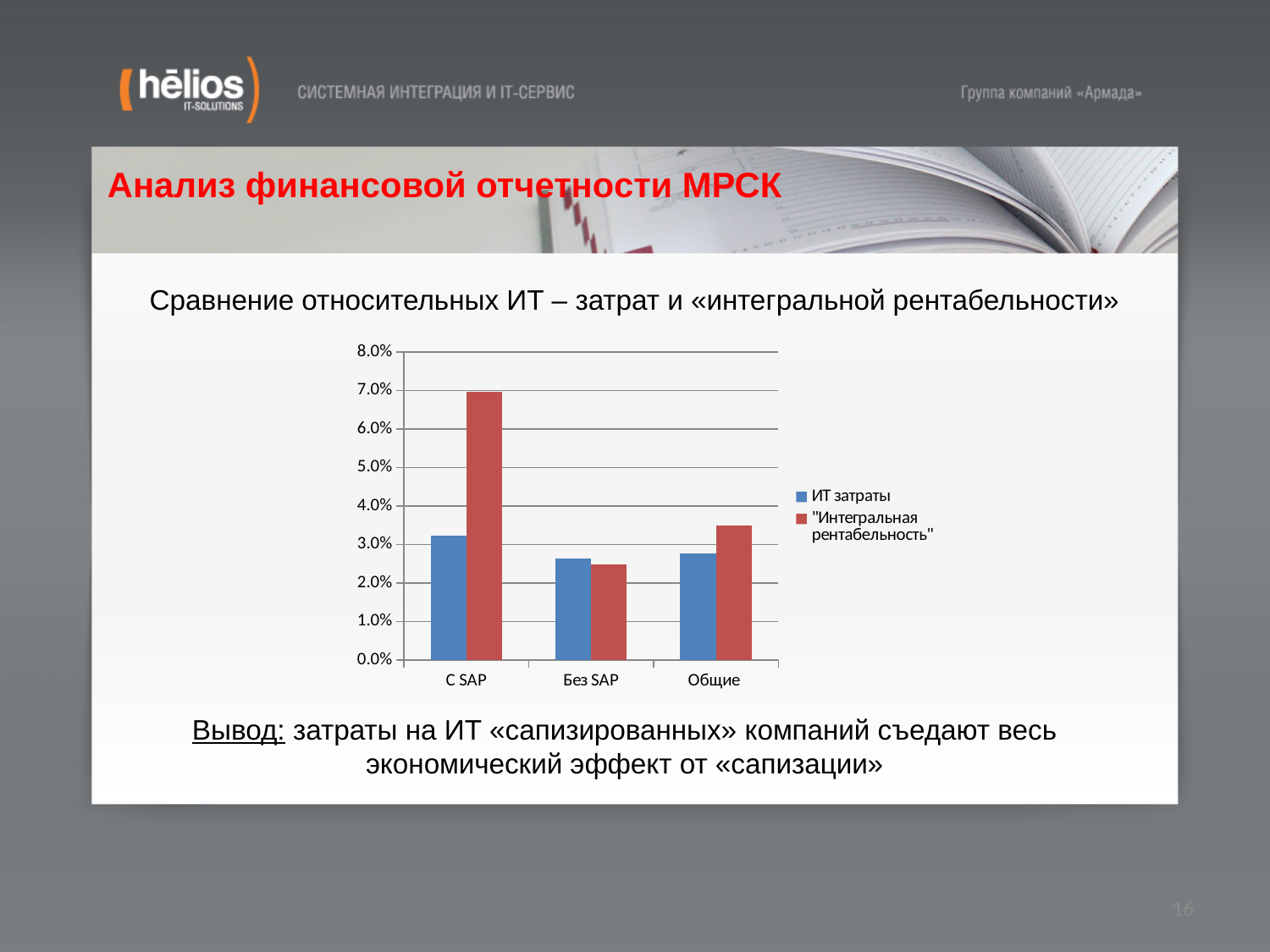
How many categories are shown on the x axis of the chart? 3 Is the value of ИТ затраты for Без SAP greater or less than 3.0%? less Which category has the lowest value for "Интегральная рентабельность"? Без SAP Is the value of "Интегральная рентабельность" for Общие greater or less than 3.0%? greater Which category has the highest value for ИТ затраты? С SAP What colour are the bars for the ИТ затраты series? blue Is the value of "Интегральная рентабельность" for С SAP greater or less than 6.0%? greater Which category has the highest value for "Интегральная рентабельность"? С SAP How many series does the chart legend list? 2 For С SAP, which is larger: ИТ затраты or "Интегральная рентабельность"? "Интегральная рентабельность" For Общие, which is larger: ИТ затраты or "Интегральная рентабельность"? "Интегральная рентабельность" What kind of chart is shown on the slide? bar chart